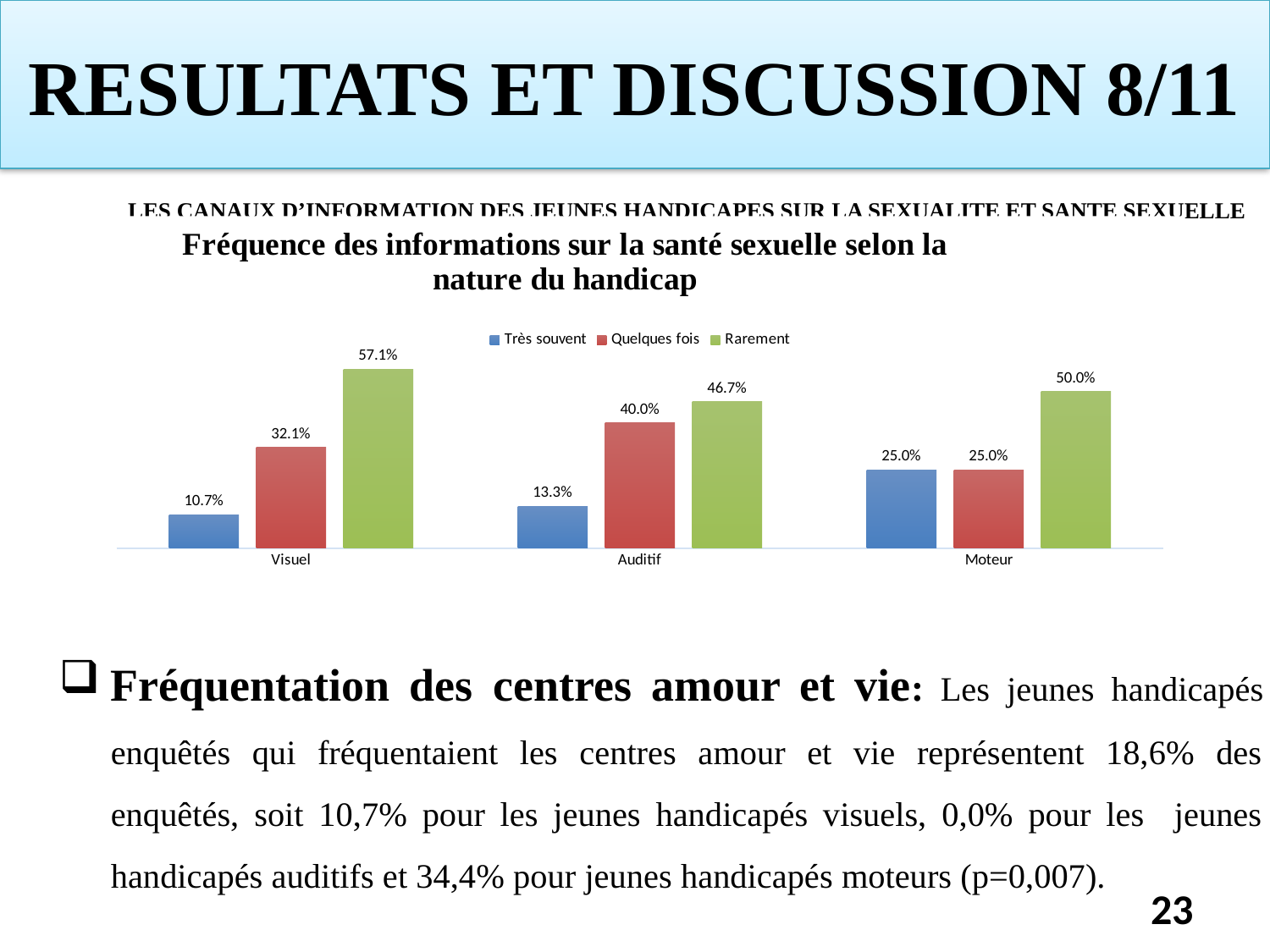
What is the value for 'Rarement' in the Visuel category? 57.1% What is the value for 'Quelques fois' in the Moteur category? 25.0% Which category has the lowest value for 'Rarement'? Auditif What kind of chart is shown on the slide? Bar chart How many handicap categories are shown on the x axis? 3 What is the difference between 'Rarement' and 'Très souvent' in the Visuel category? 46.4% Which is larger in the Auditif category: 'Quelques fois' or 'Rarement'? Rarement Which category has the highest value for 'Très souvent'? Moteur How many series does the legend list? 3 What is the value for 'Très souvent' in the Auditif category? 13.3% What is the difference between 'Quelques fois' for Auditif and 'Quelques fois' for Visuel? 7.9% Which series is shown in green in the legend? Rarement